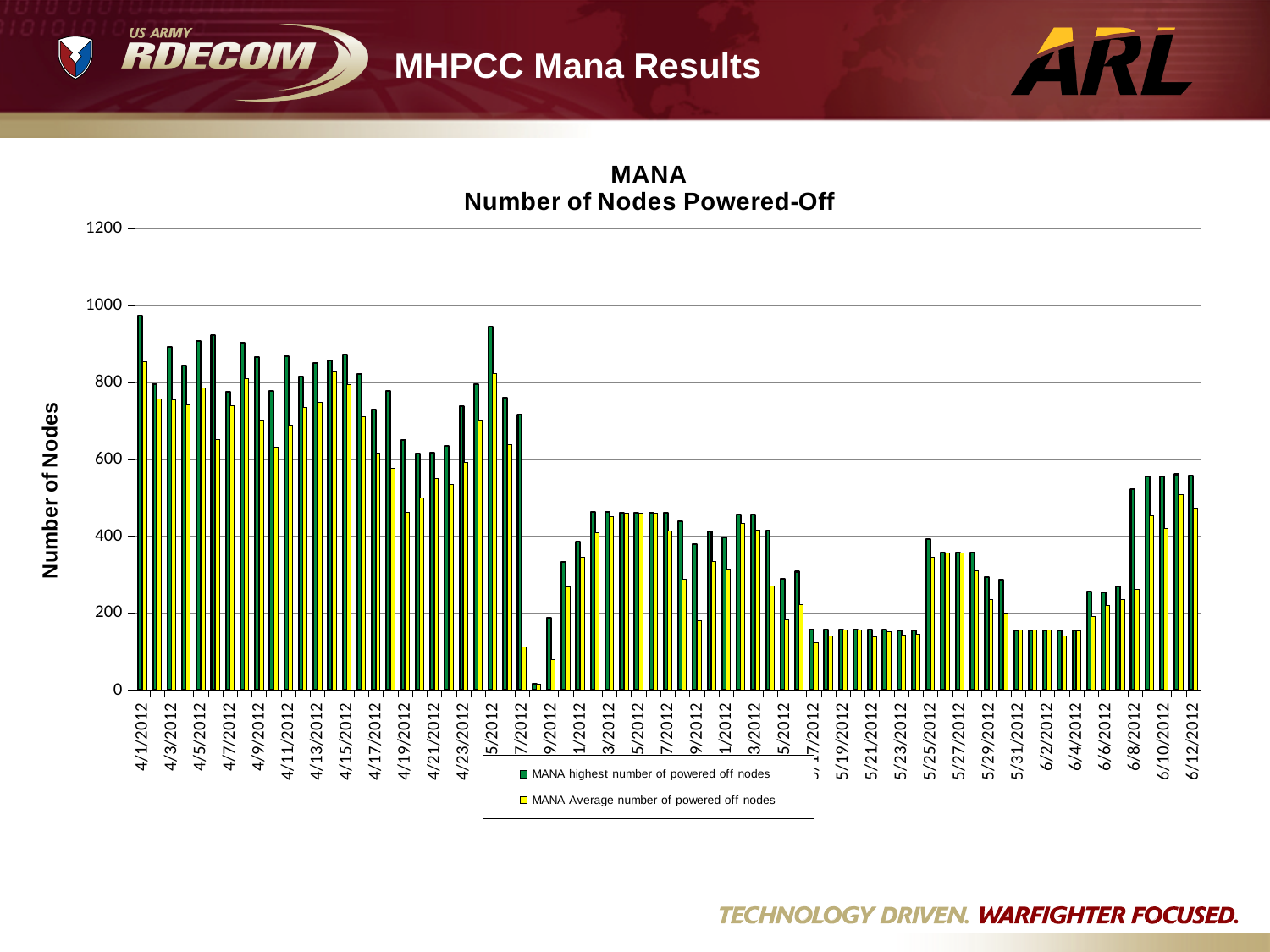
How many series does the legend of the MANA chart list? 2 Which date has the larger MANA highest number of powered off nodes, 4/1/2012 or 5/19/2012? 4/1/2012 Is the MANA highest number of powered off nodes on 5/19/2012 greater or less than 200? less What kind of chart is shown on the slide? Bar chart Is the MANA highest number of powered off nodes on 4/1/2012 greater or less than 800? greater Is the MANA highest number of powered off nodes on 4/19/2012 greater or less than 800? less What is the title of the chart? MANA Number of Nodes Powered-Off Which date has the larger MANA highest number of powered off nodes, 6/12/2012 or 5/21/2012? 6/12/2012 What is the label on the vertical axis of the chart? Number of Nodes Do the MANA highest number of powered off nodes values generally rise or fall from early April 2012 to late May 2012? fall